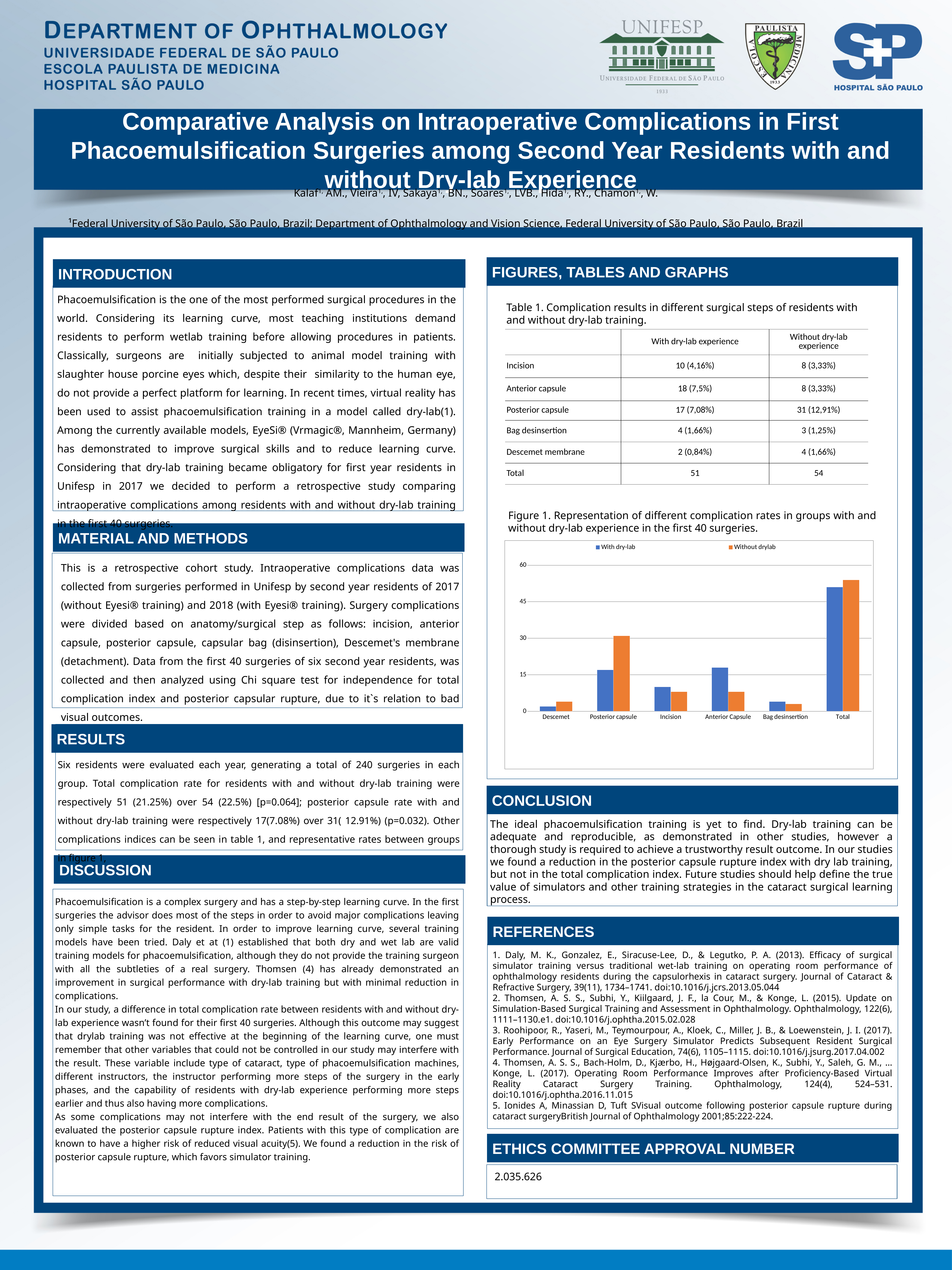
In the Figure 1 chart, for Anterior Capsule, which series has the larger value: With dry-lab or Without drylab? With dry-lab What kind of chart is shown in Figure 1? bar chart In the Figure 1 chart, which colour represents the With dry-lab series? blue In the Figure 1 chart, excluding Total, which category has the tallest Without drylab bar? Posterior capsule How many series does the legend of the Figure 1 chart list? 2 In the Figure 1 chart, is the Descemet value for Without drylab greater or less than 15? less In the Figure 1 chart, which category has the tallest bar for the Without drylab series? Total In the Figure 1 chart, is the Incision value for With dry-lab greater or less than 15? less How many categories are shown on the x axis of the Figure 1 chart? 6 In the Figure 1 chart, is the Total value for With dry-lab greater or less than 45? greater In the Figure 1 chart, which category has the shortest bar for the With dry-lab series? Descemet In the Figure 1 chart, for Posterior capsule, which series has the larger value: With dry-lab or Without drylab? Without drylab